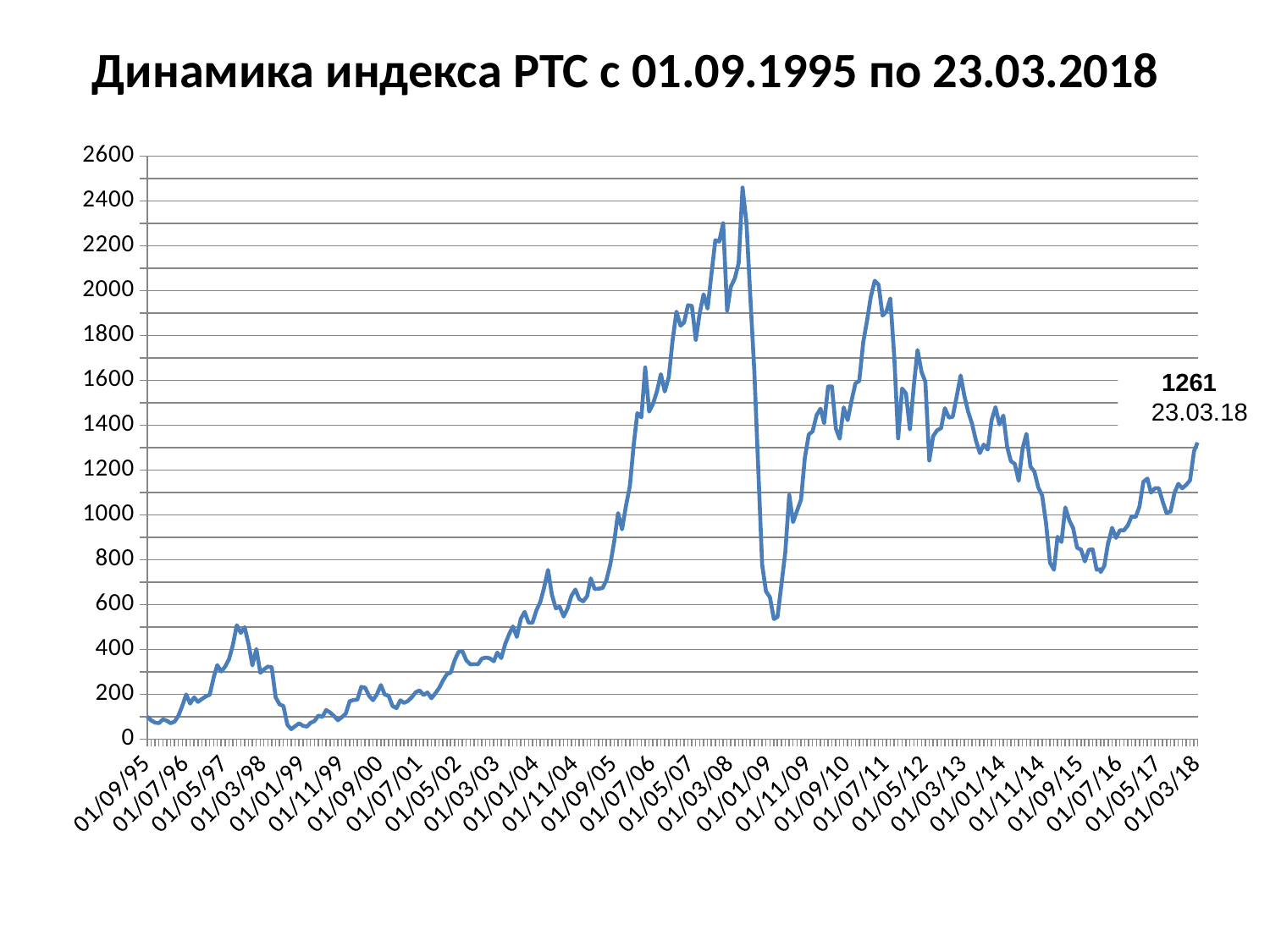
What is the title of the chart? Динамика индекса РТС с 01.09.1995 по 23.03.2018 Which is higher: the peak of the RTS index in 2008 or the peak in 2011? the peak in 2008 Is the value of the RTS index at 01/09/95 greater or less than 200? less Is the lowest value of the RTS index in early 2009 greater or less than 800? less Is the peak value of the RTS index reached in 2008 greater or less than 2200? greater How many data series are plotted on the chart? 1 Does the RTS index rise or fall overall between 01/01/99 and 01/03/08? rise What kind of chart is shown on the slide? line chart What value of the RTS index is labelled on the chart for 23.03.18? 1261 Does the RTS index rise or fall between 01/05/08 and 01/01/09? fall What is the highest value shown on the vertical axis of the chart? 2600